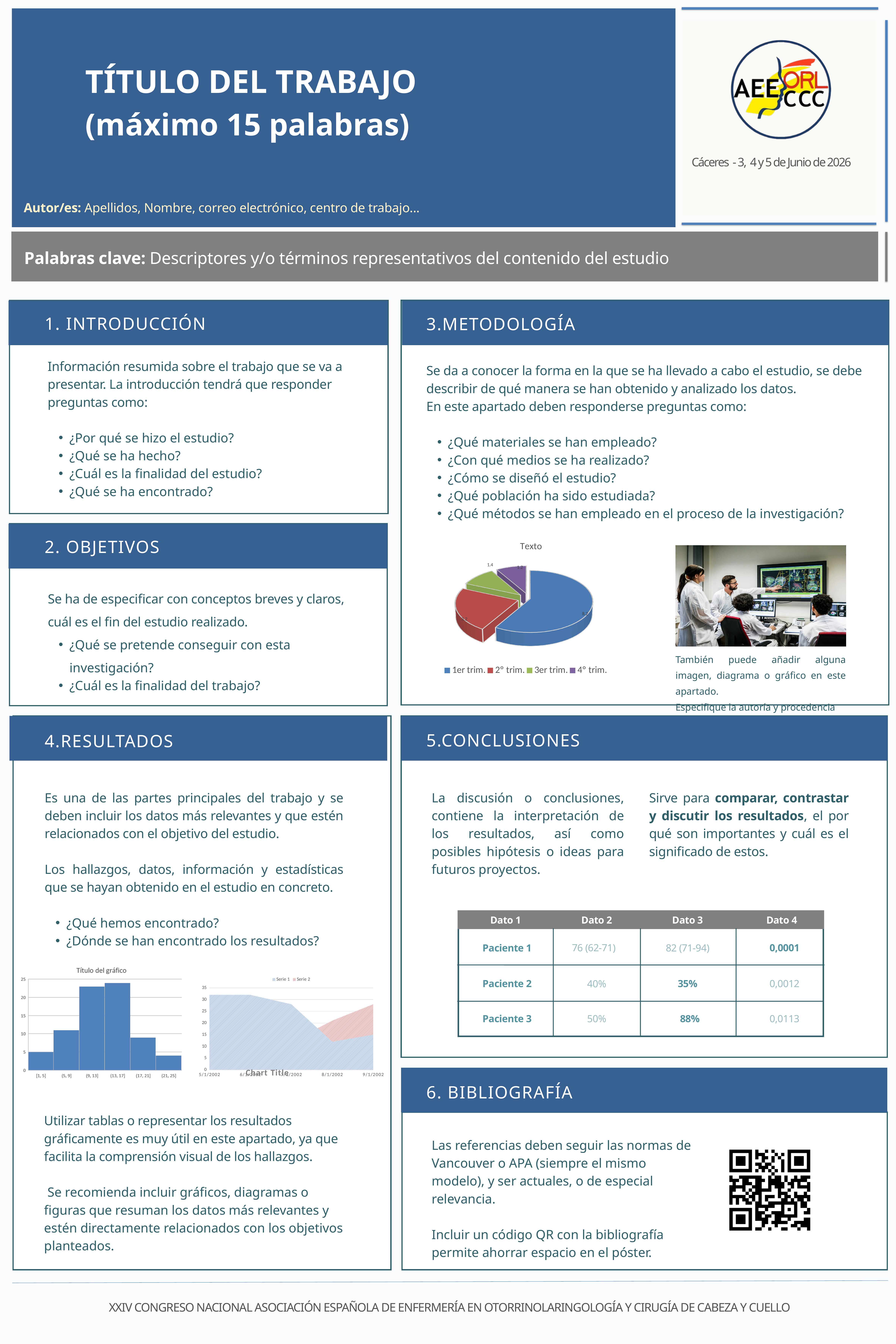
How many series does the legend of the chart titled "Chart Title" list? 2 What are the legend entries of the chart titled "Chart Title"? Serie 1, Serie 2 How many categories are shown on the x axis of the bar chart titled "Título del gráfico"? 6 What kind of chart is the chart titled "Texto" in the Metodología section? pie chart In the bar chart titled "Título del gráfico", is the value for [9, 13] greater or less than 20? greater How many entries does the legend of the pie chart titled "Texto" list? 4 In the bar chart titled "Título del gráfico", is the value for [17, 21] greater or less than 15? less What kind of chart is the chart titled "Título del gráfico" in the Resultados section? bar chart What are the legend entries of the pie chart titled "Texto"? 1er trim., 2º trim., 3er trim., 4º trim. In the bar chart titled "Título del gráfico", do the values rise or fall from [13, 17] to [21, 25]? fall In the bar chart titled "Título del gráfico", which is larger, the value for [9, 13] or the value for [1, 5]? [9, 13] In the bar chart titled "Título del gráfico", is the value for [21, 25] greater or less than 10? less